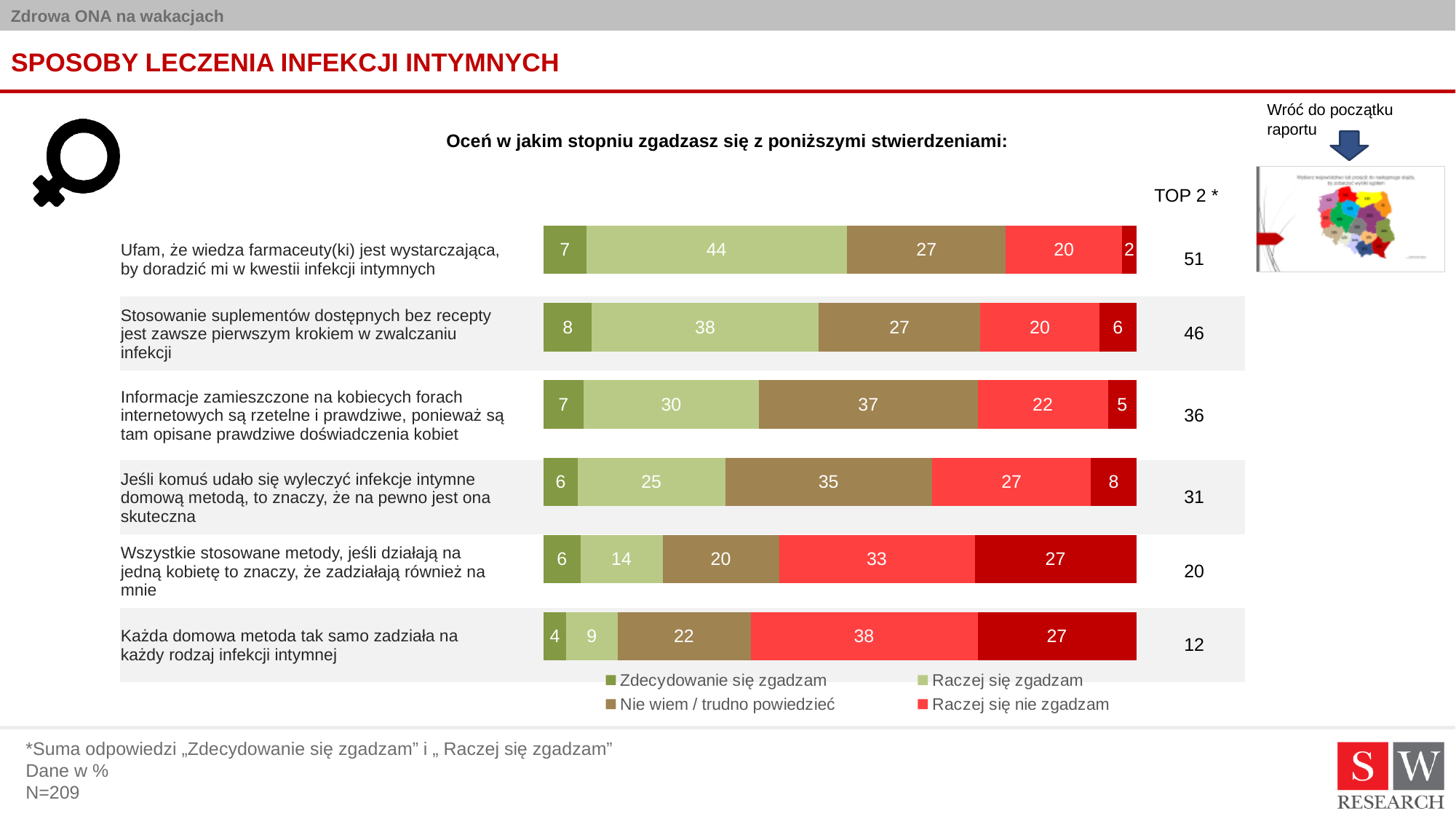
How do the TOP 2 values change going from the top statement to the bottom statement? They decrease What is the difference between the "Raczej się nie zgadzam" values for "Każda domowa metoda tak samo zadziała..." and "Wszystkie stosowane metody, jeśli działają na jedną kobietę..."? 5 What is the value for "Zdecydowanie się zgadzam" for the statement "Każda domowa metoda tak samo zadziała na każdy rodzaj infekcji intymnej"? 4 What is the TOP 2 value for the statement "Stosowanie suplementów dostępnych bez recepty jest zawsze pierwszym krokiem w zwalczaniu infekcji"? 46 Which statement has the highest TOP 2 value? Ufam, że wiedza farmaceuty(ki) jest wystarczająca, by doradzić mi w kwestii infekcji intymnych What is the total of all segments in the bar for "Ufam, że wiedza farmaceuty(ki) jest wystarczająca..."? 100 What is the value for "Raczej się zgadzam" for the statement "Ufam, że wiedza farmaceuty(ki) jest wystarczająca, by doradzić mi w kwestii infekcji intymnych"? 44 How many statements are shown in the chart? 6 Which statement has the lowest TOP 2 value? Każda domowa metoda tak samo zadziała na każdy rodzaj infekcji intymnej What kind of chart is shown on the slide? Stacked bar chart Which statement has the larger "Zdecydowanie się zgadzam" value: "Stosowanie suplementów dostępnych bez recepty..." or "Ufam, że wiedza farmaceuty(ki) jest wystarczająca..."? Stosowanie suplementów dostępnych bez recepty jest zawsze pierwszym krokiem w zwalczaniu infekcji What is the value for "Nie wiem / trudno powiedzieć" for the statement about information on women's internet forums ("Informacje zamieszczone na kobiecych forach internetowych...")? 37